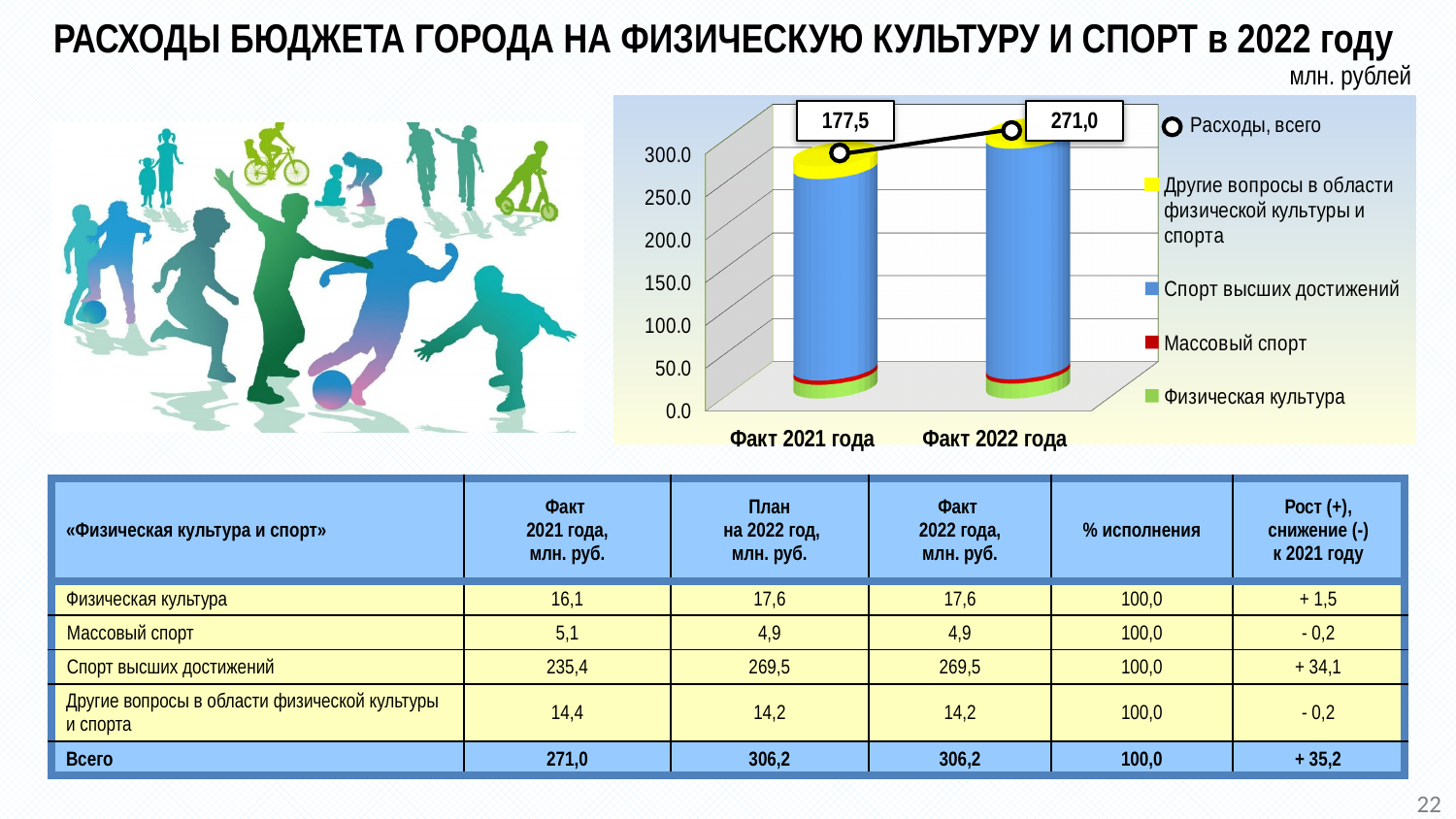
What kind of chart is shown on the slide? bar chart How many categories are shown on the x axis of the chart? 2 What value is labelled for «Расходы, всего» at «Факт 2022 года» in the chart? 271,0 Is the total height of the stacked bar for «Факт 2021 года» greater or less than 200.0? greater How many series does the chart legend list? 5 What is the difference between the labelled «Расходы, всего» values for «Факт 2022 года» and «Факт 2021 года» in the chart? 93,5 What value is labelled for «Расходы, всего» at «Факт 2021 года» in the chart? 177,5 Which category has the higher labelled «Расходы, всего» value in the chart, «Факт 2021 года» or «Факт 2022 года»? Факт 2022 года Which series forms the largest segment of the stacked bars in the chart? Спорт высших достижений What unit is indicated above the chart? млн. рублей What colour represents «Спорт высших достижений» in the chart? blue Does the «Расходы, всего» line rise or fall from «Факт 2021 года» to «Факт 2022 года»? rises